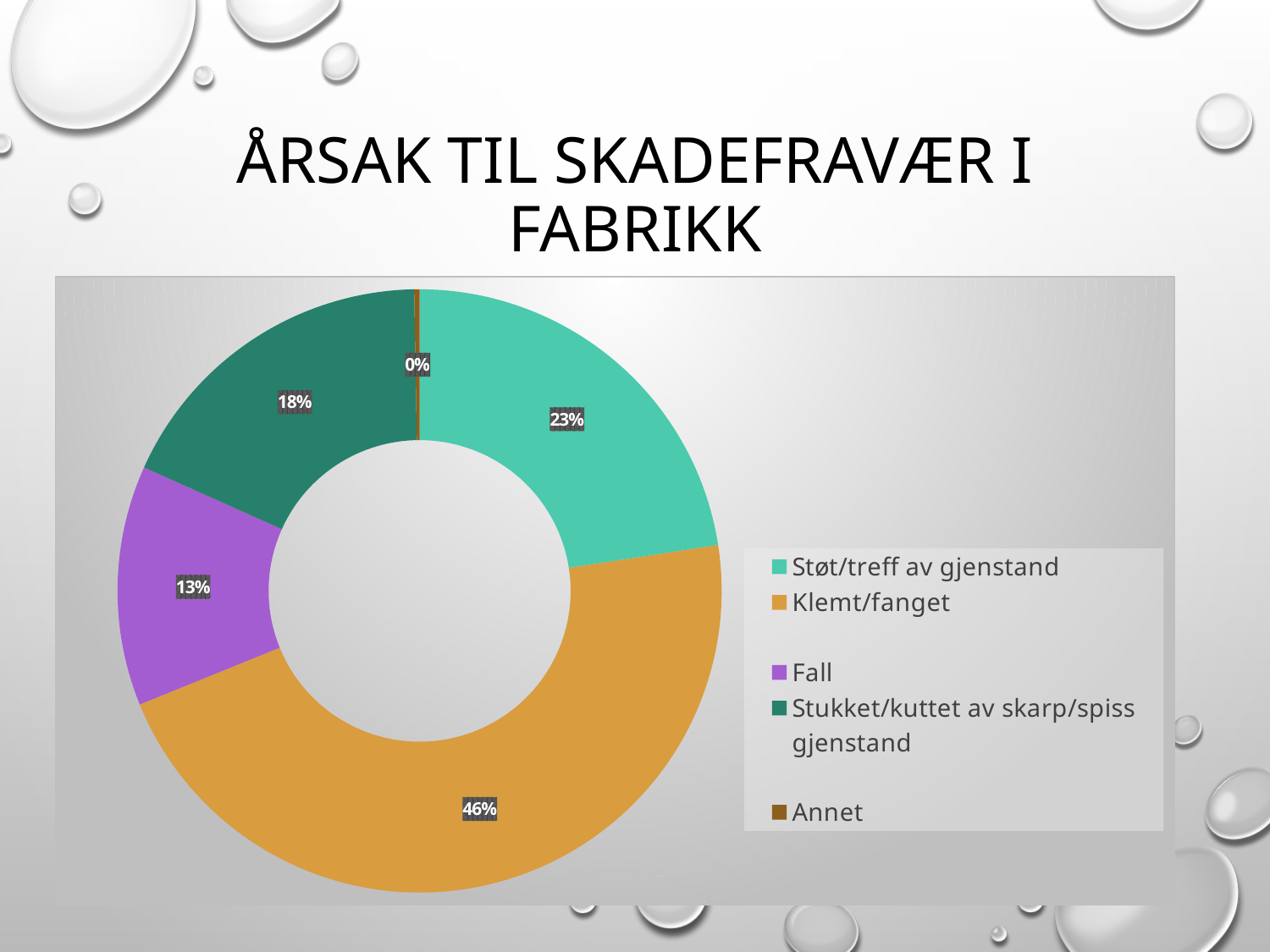
Which category has the smallest share? Annet What is the value shown for Annet? 0% What is the difference in percentage points between Klemt/fanget and Støt/treff av gjenstand? 23 What is the value shown for Støt/treff av gjenstand? 23% What is the value shown for Fall? 13% What kind of chart is shown on the slide? Doughnut (pie) chart How many categories does the legend list? 5 Which is larger, Stukket/kuttet av skarp/spiss gjenstand or Fall? Stukket/kuttet av skarp/spiss gjenstand Which category has the largest share? Klemt/fanget What share of the chart does Klemt/fanget account for? 46% What is the title of the slide? ÅRSAK TIL SKADEFRAVÆR I FABRIKK What is the value shown for Stukket/kuttet av skarp/spiss gjenstand? 18%